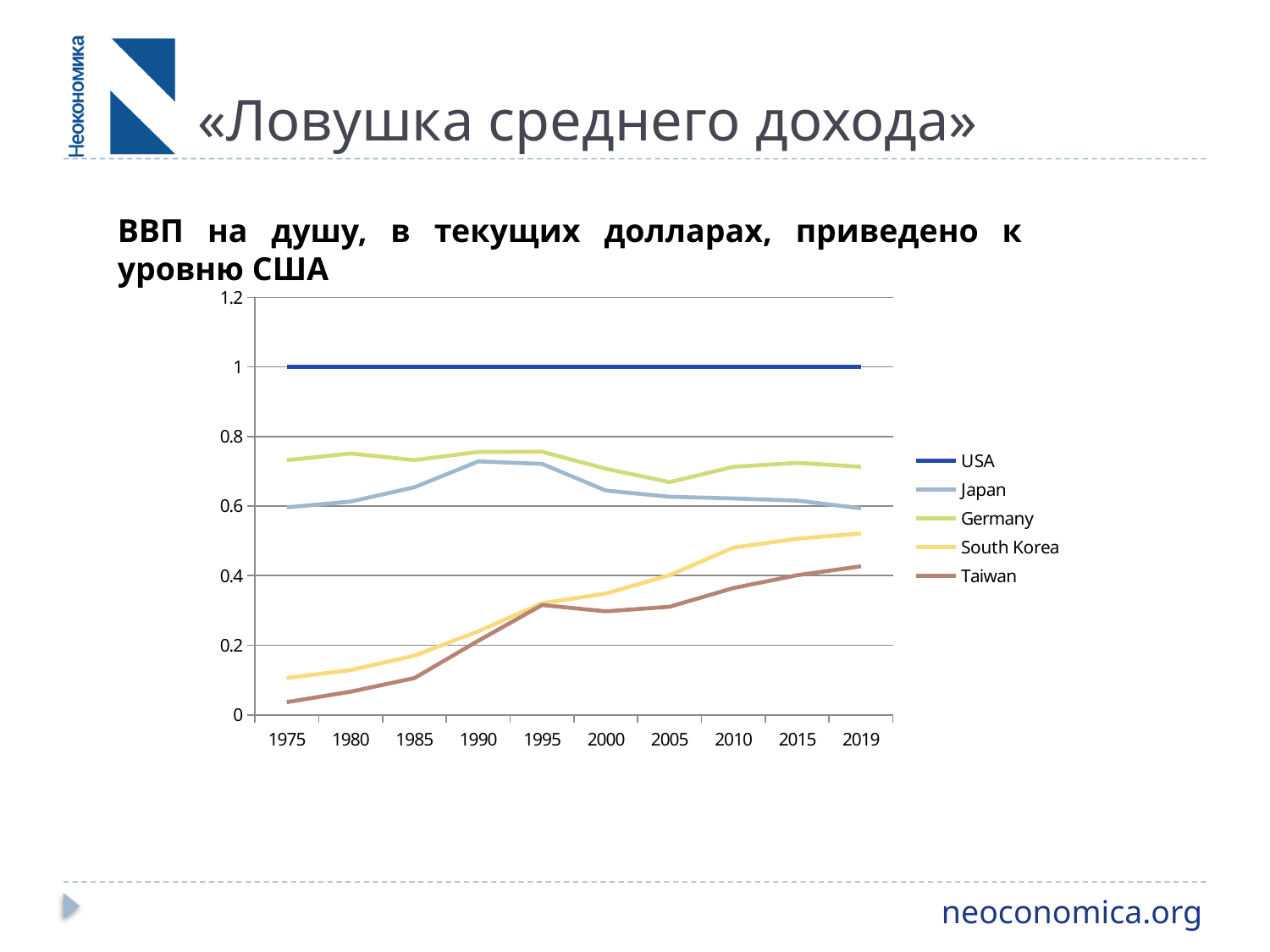
How many series does the legend list? 5 Which series has the lowest value in 1975? Taiwan What is the value for USA in 2000? 1 Does the value for South Korea rise or fall from 1975 to 2019? rise What kind of chart is shown on the slide? line chart Is the value for Germany in 1975 greater or less than 0.6? greater Which series is drawn in dark blue in the legend? USA Is the value for South Korea in 1975 greater or less than 0.2? less Is the value for Taiwan in 1975 greater or less than 0.2? less How many years are marked along the x axis? 10 In 2019, which is larger: the value for Germany or the value for Japan? Germany